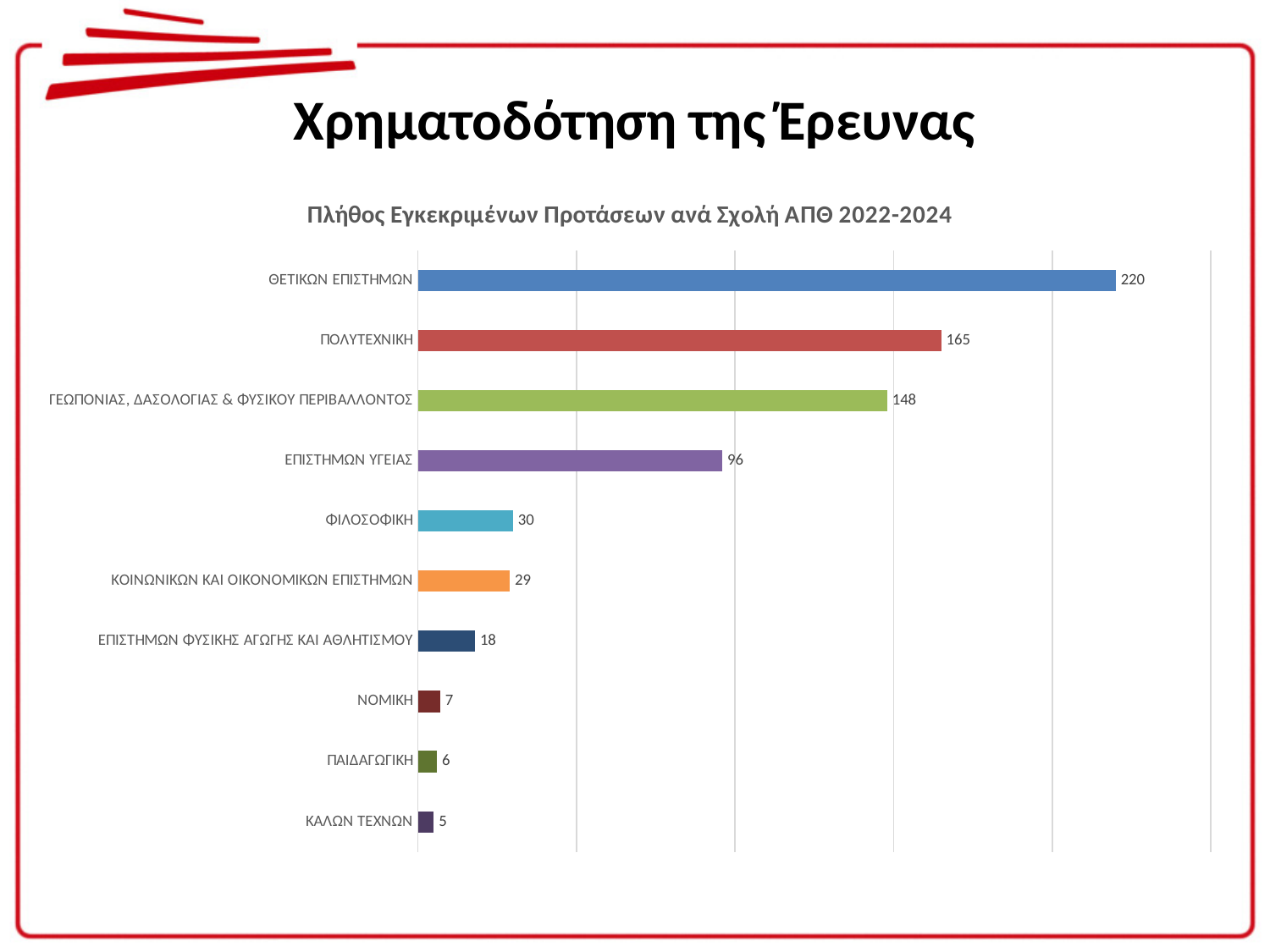
What is the title of the chart? Πλήθος Εγκεκριμένων Προτάσεων ανά Σχολή ΑΠΘ 2022-2024 What is the value for ΘΕΤΙΚΩΝ ΕΠΙΣΤΗΜΩΝ? 220 What is the difference between the values for ΠΟΛΥΤΕΧΝΙΚΗ and ΓΕΩΠΟΝΙΑΣ, ΔΑΣΟΛΟΓΙΑΣ & ΦΥΣΙΚΟΥ ΠΕΡΙΒΑΛΛΟΝΤΟΣ? 17 Which is larger, the value for ΦΙΛΟΣΟΦΙΚΗ or the value for ΕΠΙΣΤΗΜΩΝ ΦΥΣΙΚΗΣ ΑΓΩΓΗΣ ΚΑΙ ΑΘΛΗΤΙΣΜΟΥ? ΦΙΛΟΣΟΦΙΚΗ What is the value for ΝΟΜΙΚΗ? 7 What is the difference between the values for ΘΕΤΙΚΩΝ ΕΠΙΣΤΗΜΩΝ and ΕΠΙΣΤΗΜΩΝ ΥΓΕΙΑΣ? 124 Which school has the highest number of approved proposals? ΘΕΤΙΚΩΝ ΕΠΙΣΤΗΜΩΝ Which school has the lowest number of approved proposals? ΚΑΛΩΝ ΤΕΧΝΩΝ What is the value for ΚΟΙΝΩΝΙΚΩΝ ΚΑΙ ΟΙΚΟΝΟΜΙΚΩΝ ΕΠΙΣΤΗΜΩΝ? 29 How many schools are shown in the chart? 10 What kind of chart is shown on the slide? Bar chart What is the value for ΕΠΙΣΤΗΜΩΝ ΥΓΕΙΑΣ? 96